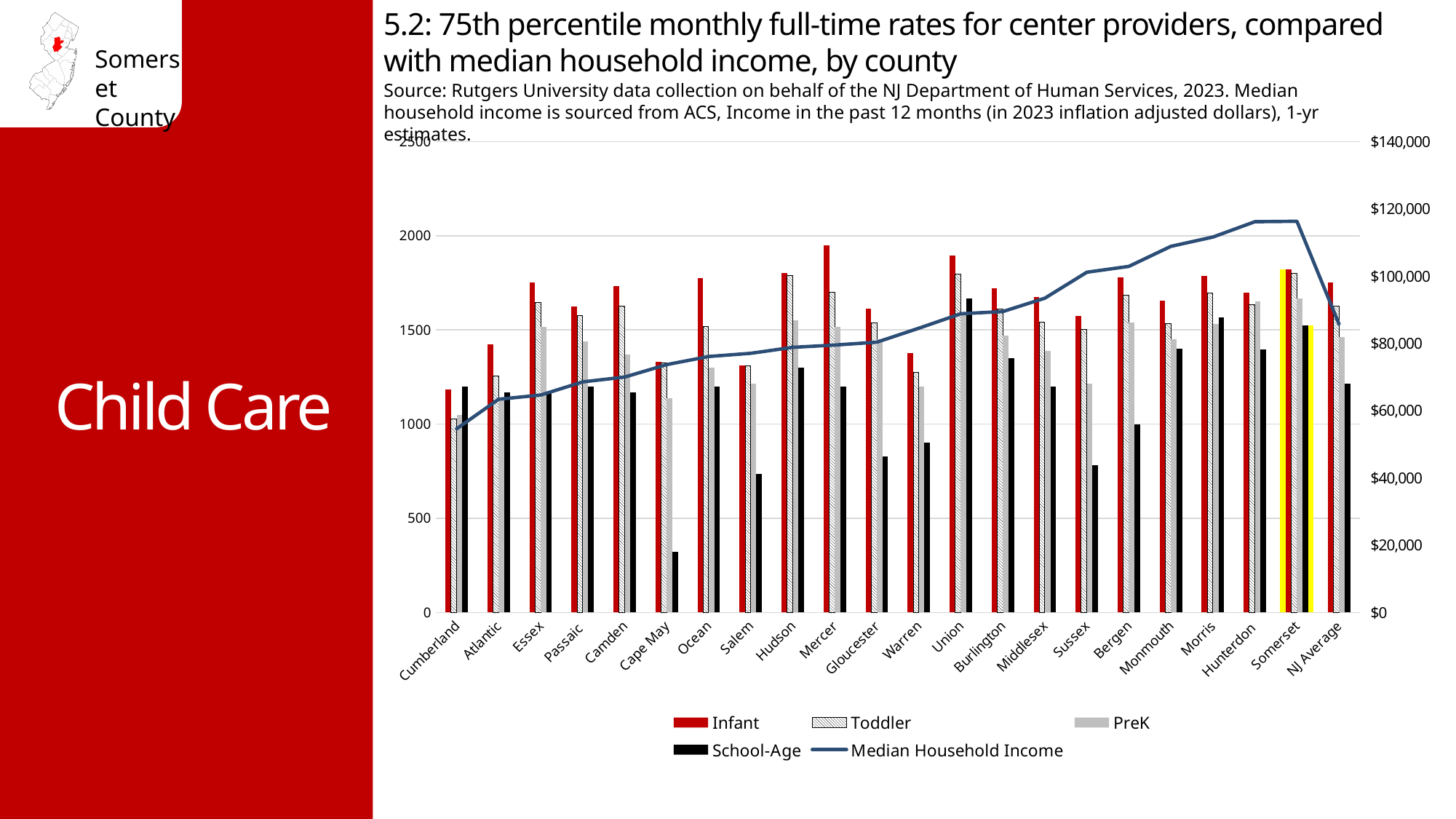
How many series does the legend list? 5 Which county has the highest Infant rate? Mercer Is the School-Age rate for Cape May greater or less than 500? less Is the Infant rate for Mercer greater or less than 1500? greater Which county has the highest School-Age rate? Union Which is larger, the Infant rate for Mercer or the Infant rate for Cumberland? Mercer Is the Median Household Income for Somerset greater or less than $100,000? greater How many counties/categories are shown along the x axis? 22 Which county has the lowest School-Age rate? Cape May Does the Median Household Income line generally rise or fall from Cumberland to Somerset? rise What kind of chart is shown on the slide? Bar chart with a line Which county has the lowest Infant rate? Cumberland